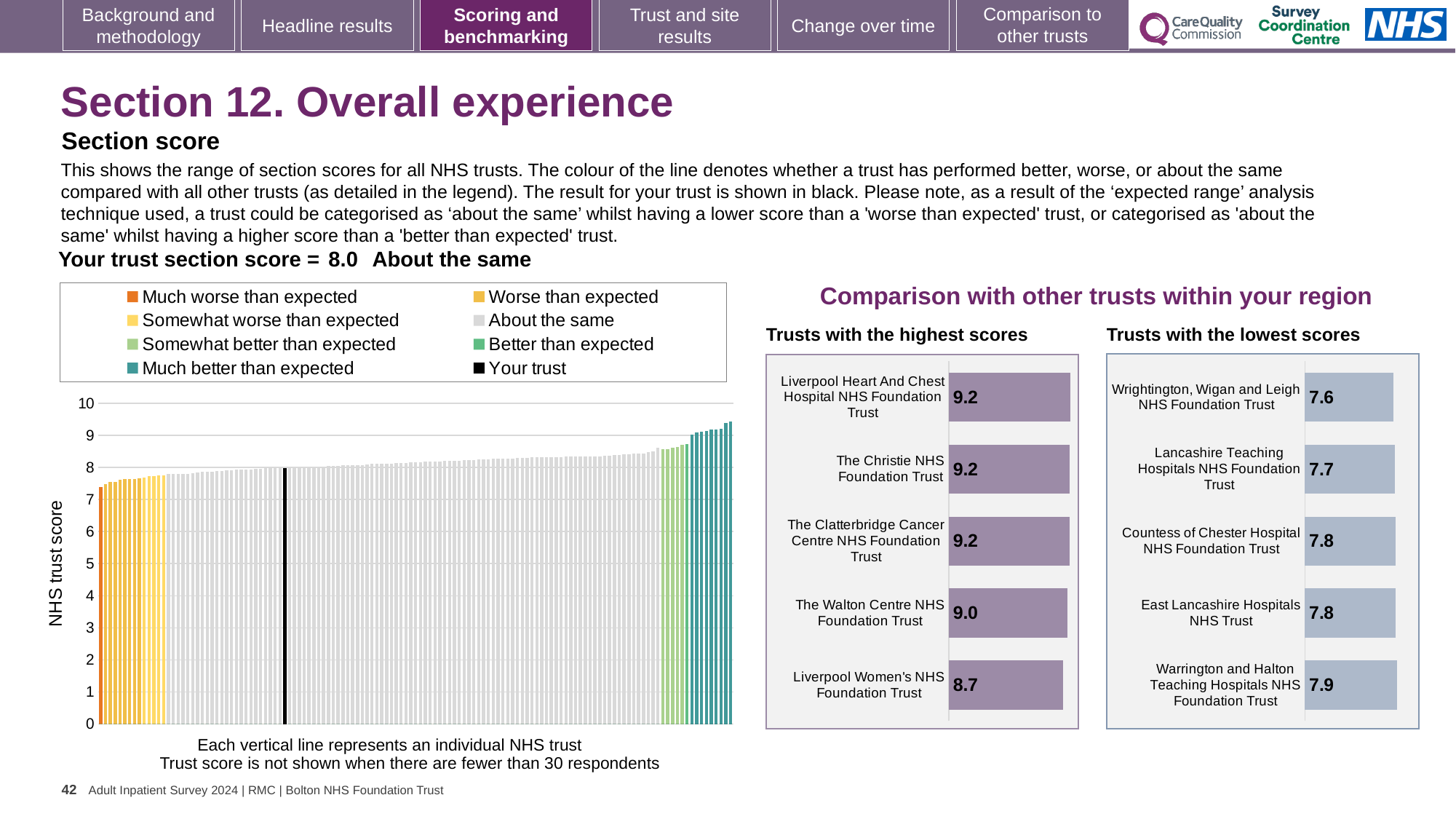
What kind of chart is the NHS trust score chart on the left of the slide? Bar chart In the 'Trusts with the lowest scores' chart, what is the difference between the score for Warrington and Halton Teaching Hospitals NHS Foundation Trust and Wrightington, Wigan and Leigh NHS Foundation Trust? 0.3 How many trusts are listed in the 'Trusts with the lowest scores' chart? 5 In the 'Trusts with the highest scores' chart, what is the difference between the score for Liverpool Heart And Chest Hospital NHS Foundation Trust and Liverpool Women's NHS Foundation Trust? 0.5 In the NHS trust score chart on the left, is the value for the leftmost (orange) trust greater or less than 8? less How many entries does the legend of the NHS trust score chart on the left list? 8 In the 'Trusts with the lowest scores' chart, which trust has the lowest score? Wrightington, Wigan and Leigh NHS Foundation Trust In the 'Trusts with the lowest scores' chart, which trust has the highest score? Warrington and Halton Teaching Hospitals NHS Foundation Trust In the 'Trusts with the highest scores' chart, which trust has the lowest score? Liverpool Women's NHS Foundation Trust In the 'Trusts with the lowest scores' chart, what is the score for Countess of Chester Hospital NHS Foundation Trust? 7.8 In the 'Trusts with the highest scores' chart, what is the score for The Walton Centre NHS Foundation Trust? 9.0 In the 'Trusts with the highest scores' chart, what is the score for Liverpool Women's NHS Foundation Trust? 8.7